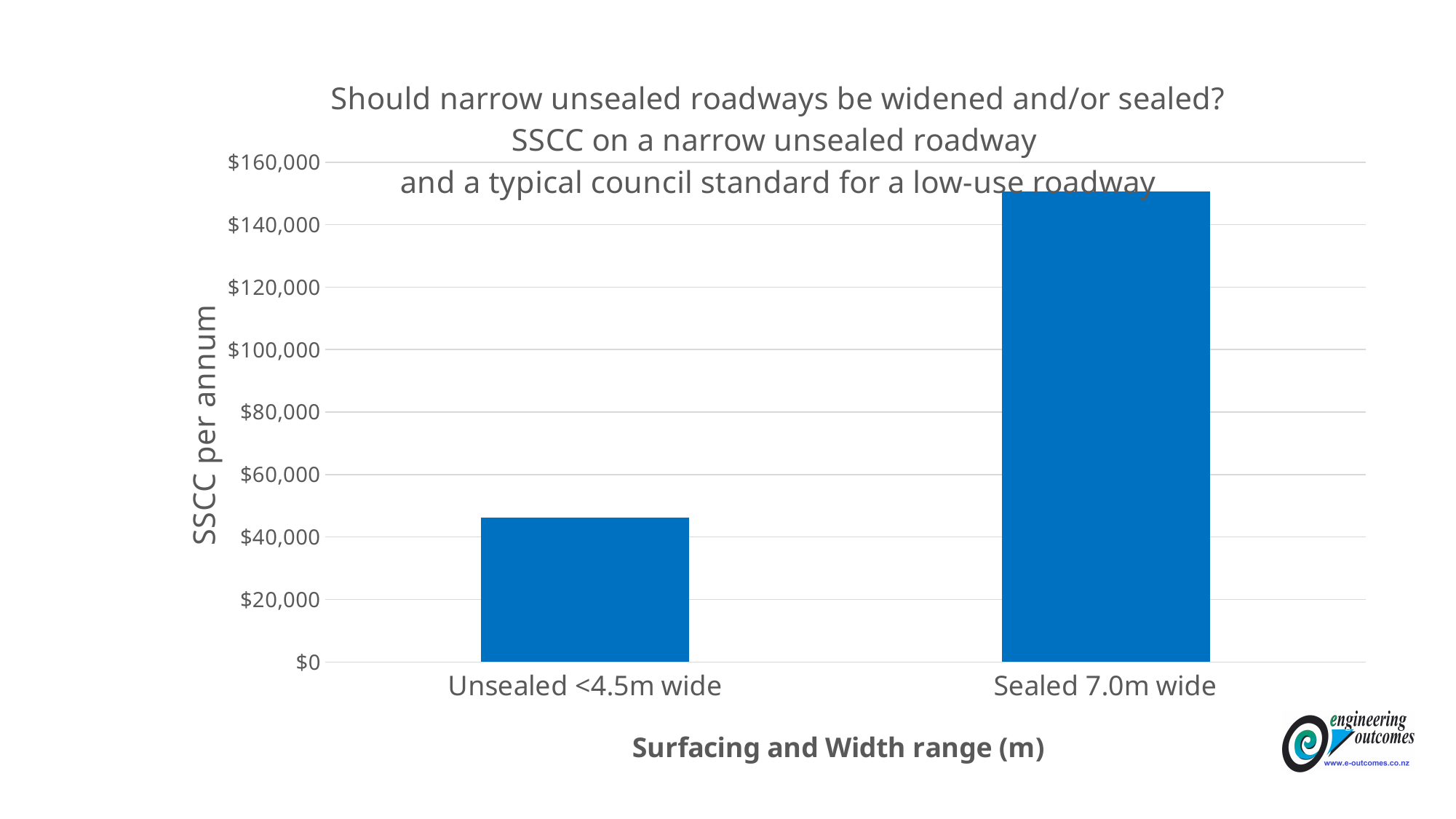
Which category has the highest SSCC per annum? Sealed 7.0m wide What is the label of the x axis? Surfacing and Width range (m) Do the values rise or fall from left to right along the x axis? rise Is the value for Unsealed <4.5m wide greater or less than $40,000? greater Which has a larger SSCC per annum, Unsealed <4.5m wide or Sealed 7.0m wide? Sealed 7.0m wide Is the value for Sealed 7.0m wide greater or less than $140,000? greater Is the value for Sealed 7.0m wide greater or less than $160,000? less Which category has the lowest SSCC per annum? Unsealed <4.5m wide What kind of chart is shown on the slide? bar chart How many categories are plotted on the x axis? 2 What is the label of the y axis? SSCC per annum